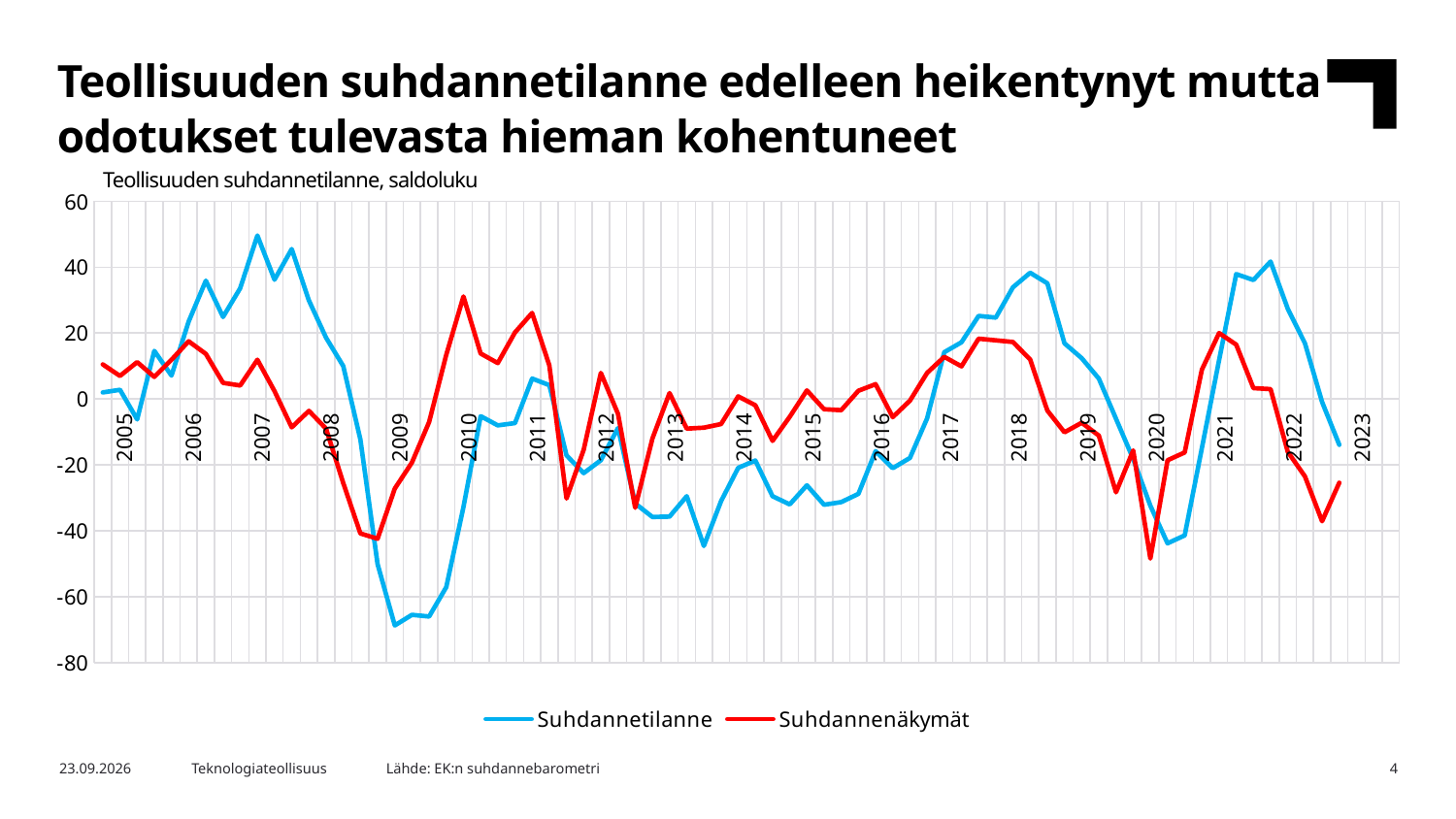
How many year labels are shown on the x axis? 19 How many series does the legend list? 2 What kind of chart is shown on the slide? line chart What is the title of the chart? Teollisuuden suhdannetilanne, saldoluku Is the lowest value of the Suhdannenäkymät series, around 2020, greater or less than -40? less Which series reaches the highest value anywhere on the chart? Suhdannetilanne Is the lowest value of the Suhdannetilanne series, around 2009, greater or less than -60? less Is the highest value of the Suhdannetilanne series, around 2007, greater or less than 40? greater Which colour is used for the Suhdannenäkymät series? red Which series reaches the lowest value anywhere on the chart? Suhdannetilanne